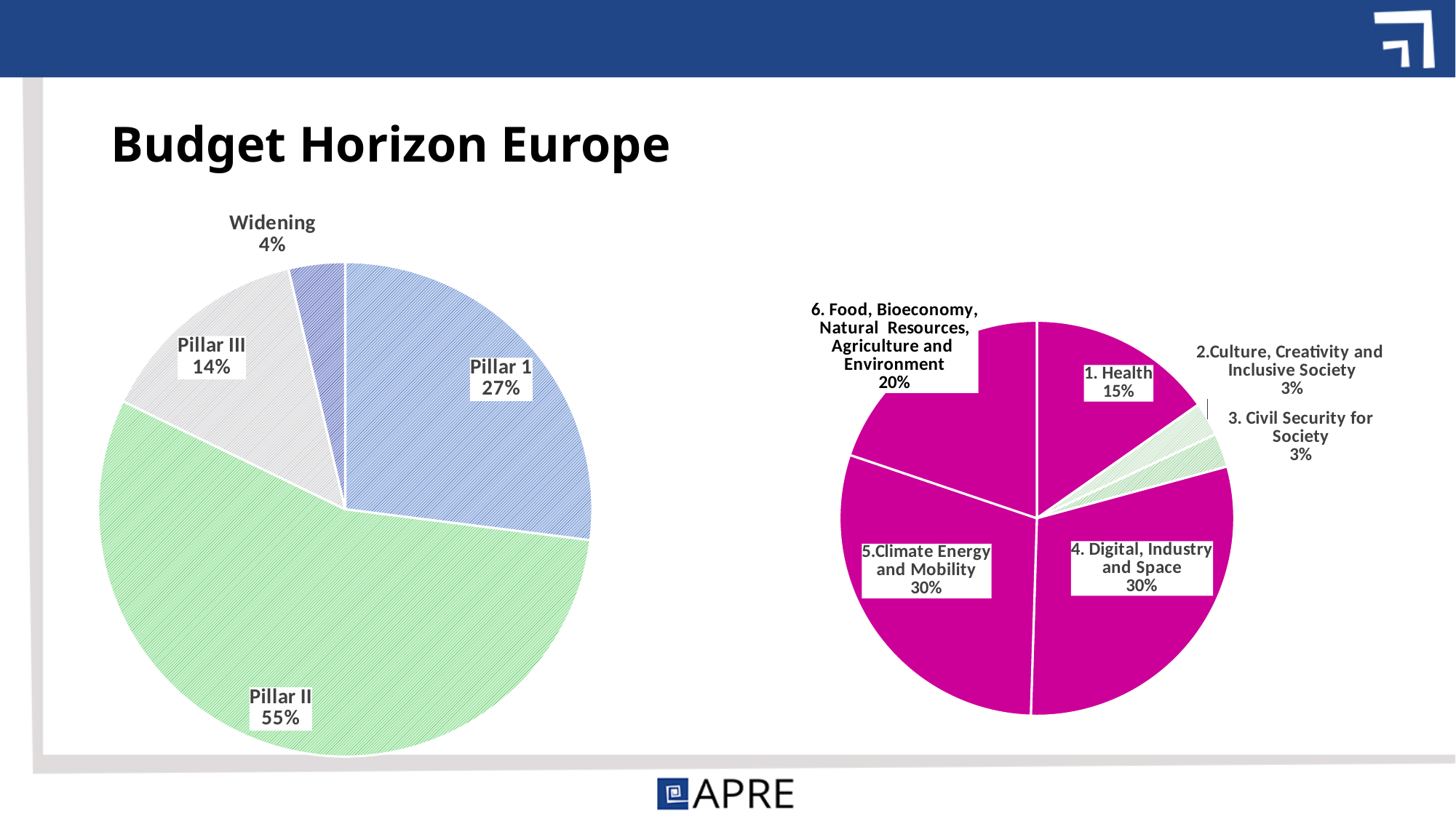
In the right pie chart, what share does 6. Food, Bioeconomy, Natural Resources, Agriculture and Environment have? 20% What is the title of the slide? Budget Horizon Europe In the right pie chart, what share does 1. Health have? 15% In the right pie chart, which is larger, 1. Health or 3. Civil Security for Society? 1. Health In the left pie chart, what share does Widening have? 4% In the left pie chart, what share does Pillar II have? 55% In the right pie chart, how many slices are there? 6 In the left pie chart, how many slices are there? 4 In the left pie chart, which slice is the largest? Pillar II In the left pie chart, what is the difference in percentage points between Pillar 1 and Pillar III? 13 In the left pie chart, which slice is the smallest? Widening What kind of chart is the chart on the right? Pie chart